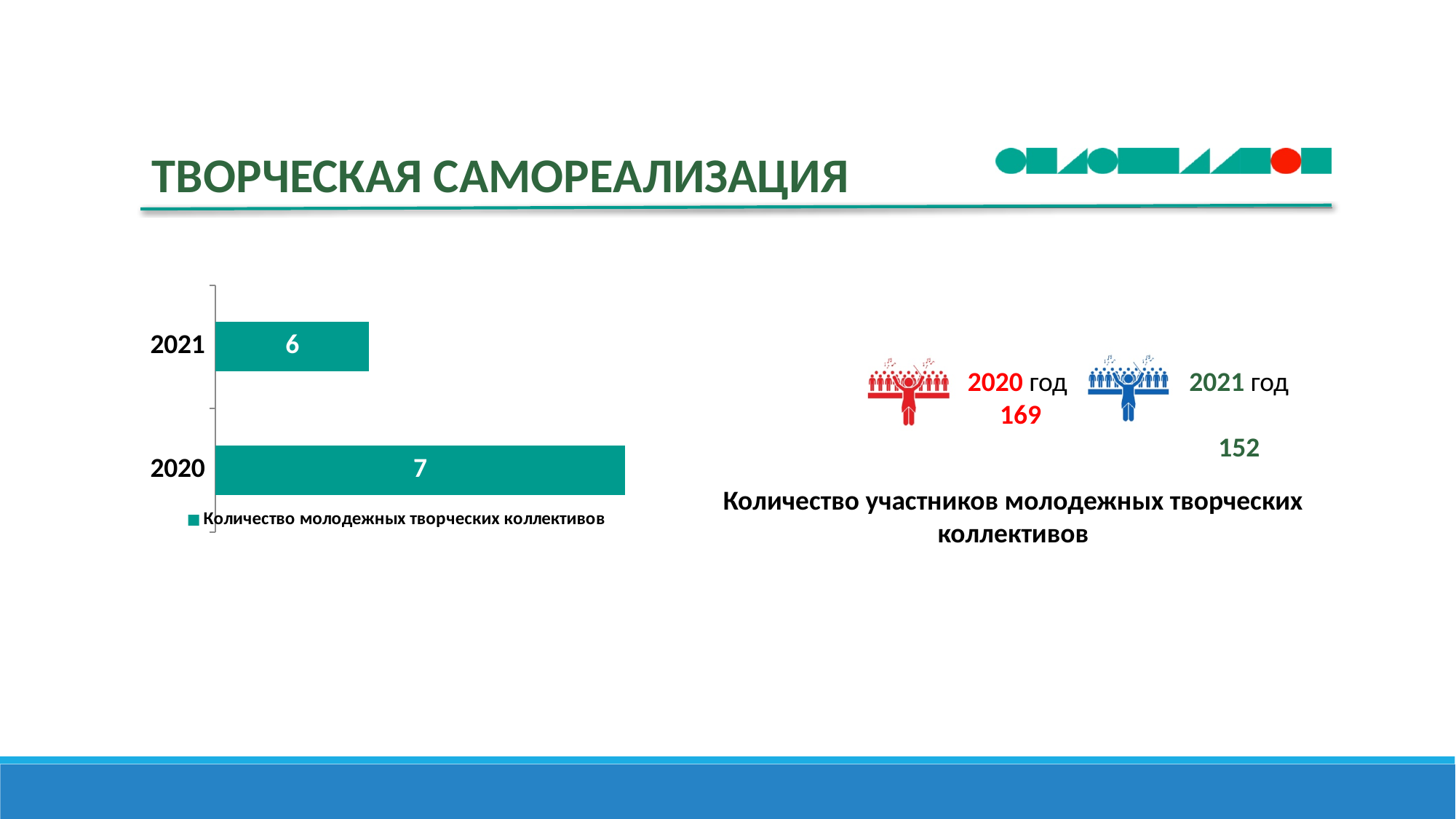
Which year has the lowest value in the bar chart? 2021 How many series does the legend of the bar chart list? 1 How many categories are shown in the bar chart? 2 What is the legend entry of the bar chart? Количество молодежных творческих коллективов What is the value for 2020 in the bar chart? 7 What is the difference between the values for 2020 and 2021 in the bar chart? 1 Which is larger in the bar chart, the value for 2020 or the value for 2021? 2020 What colour are the bars in the bar chart? Teal Which year has the highest value in the bar chart? 2020 What kind of chart is shown on the left of the slide? Bar chart What is the value for 2021 in the bar chart? 6 Did the number of youth creative collectives rise or fall from 2020 to 2021 according to the bar chart? Fall